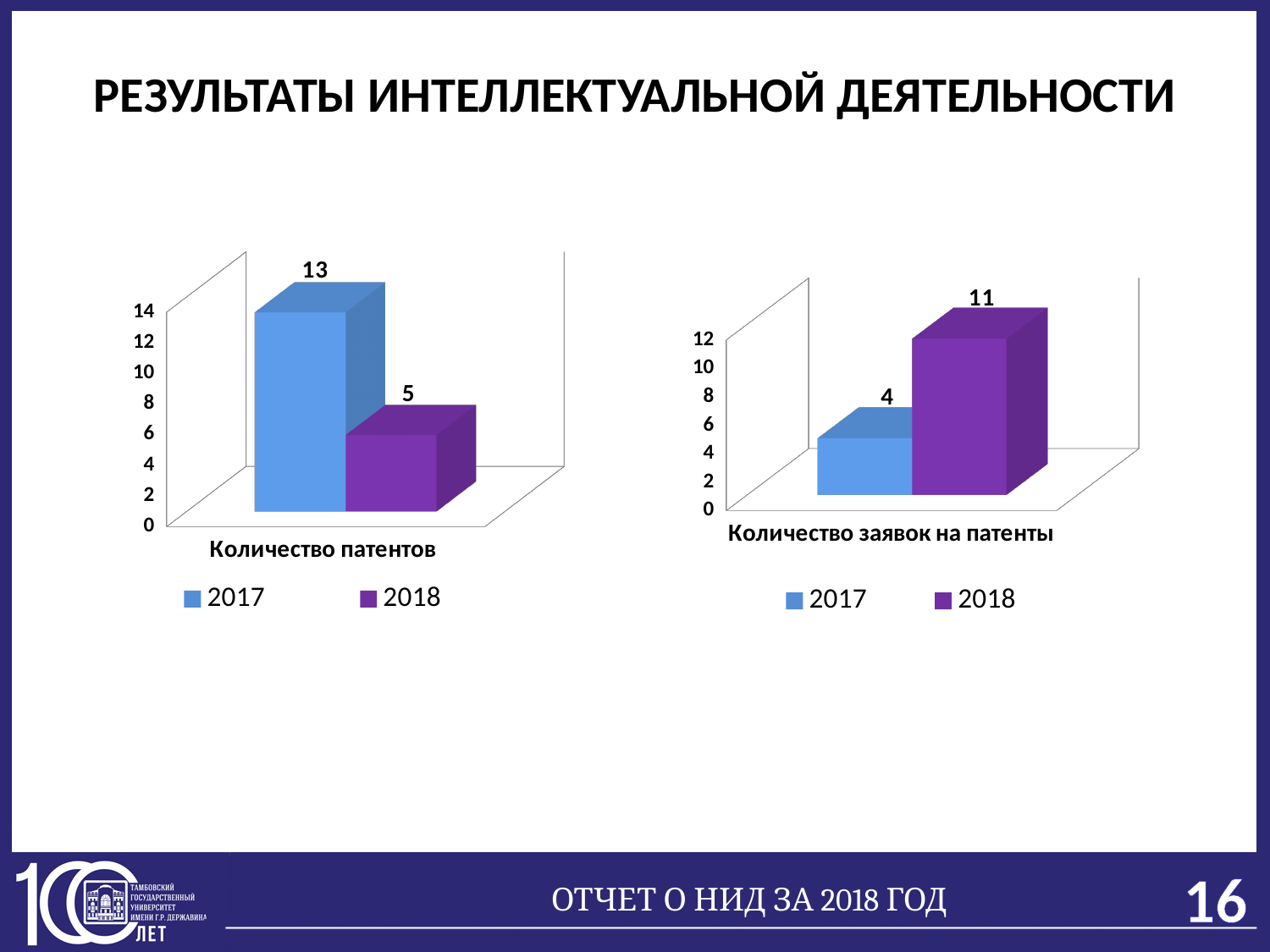
What kind of chart is the right chart (Количество заявок на патенты)? Bar chart In the right chart (Количество заявок на патенты), what is the value for 2018? 11 In the left chart (Количество патентов), which year has the higher value? 2017 In the left chart (Количество патентов), what is the value for 2017? 13 In the left chart (Количество патентов), what colour is the bar for 2018? Purple How many series does the legend of the left chart (Количество патентов) list? 2 In the left chart (Количество патентов), what is the value for 2018? 5 In the right chart (Количество заявок на патенты), what is the difference between the 2018 and 2017 values? 7 In the right chart (Количество заявок на патенты), what is the value for 2017? 4 In the right chart (Количество заявок на патенты), which year has the lower value? 2017 In the right chart (Количество заявок на патенты), is the value for 2018 larger than the value for 2017? Yes In the left chart (Количество патентов), what is the difference between the 2017 and 2018 values? 8